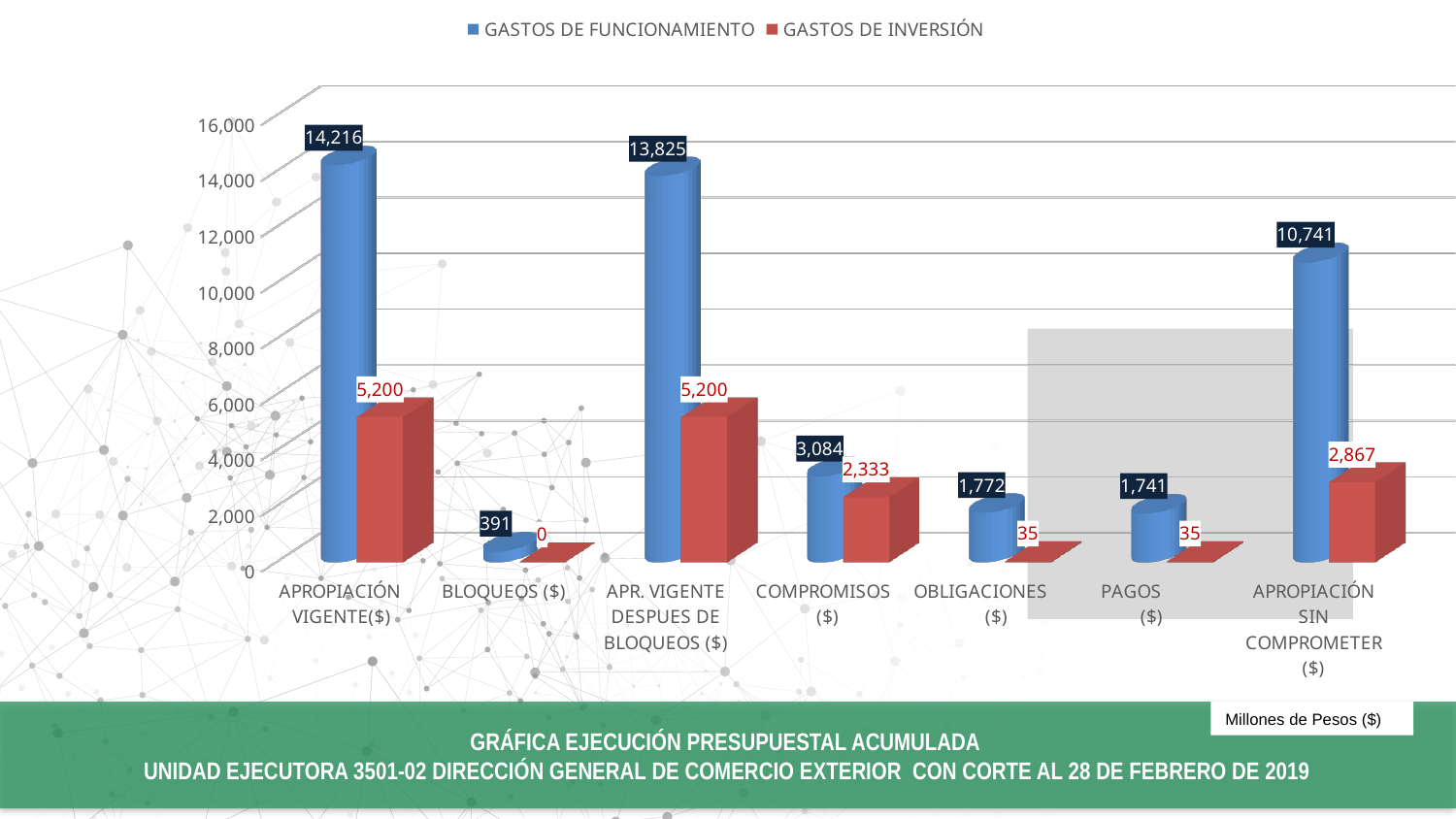
What is the value of GASTOS DE INVERSIÓN for COMPROMISOS ($)? 2,333 Which category has the lowest GASTOS DE FUNCIONAMIENTO value? BLOQUEOS ($) What is the difference between GASTOS DE FUNCIONAMIENTO for APROPIACIÓN VIGENTE($) and for APR. VIGENTE DESPUES DE BLOQUEOS ($)? 391 What is the value of GASTOS DE FUNCIONAMIENTO for APROPIACIÓN VIGENTE($)? 14,216 What kind of chart is shown on the slide? Bar chart How many categories are shown on the x axis? 7 Which category has the highest GASTOS DE FUNCIONAMIENTO value? APROPIACIÓN VIGENTE($) What is the value of GASTOS DE FUNCIONAMIENTO for PAGOS ($)? 1,741 Which is larger for COMPROMISOS ($): GASTOS DE FUNCIONAMIENTO or GASTOS DE INVERSIÓN? GASTOS DE FUNCIONAMIENTO How many series does the legend list? 2 What colour represents GASTOS DE INVERSIÓN in the chart? Red What is the value of GASTOS DE INVERSIÓN for BLOQUEOS ($)? 0